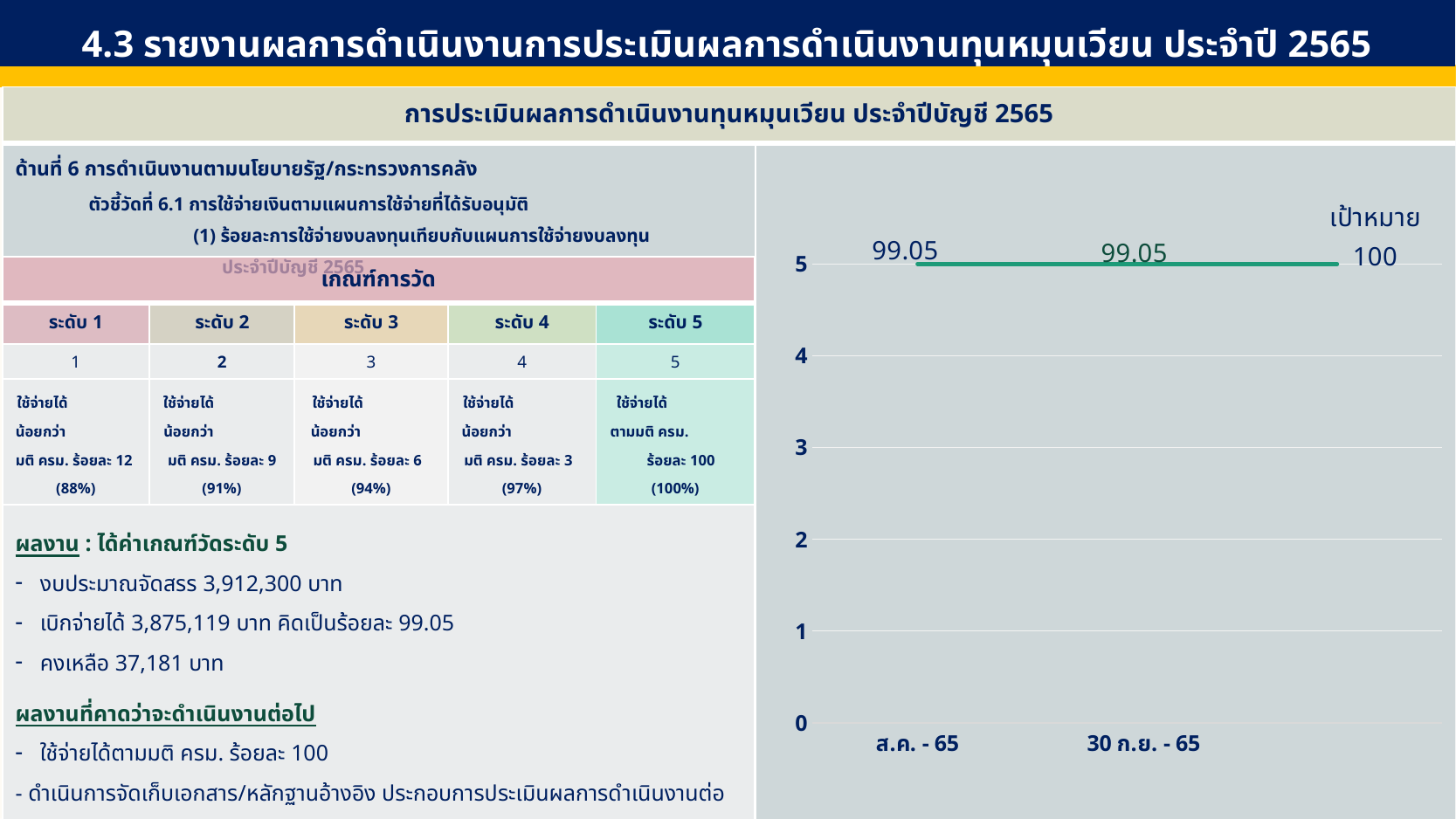
What is the label of the first category on the x axis of the chart? ส.ค. - 65 What target value (เป้าหมาย) is printed at the right end of the line in the chart? 100 Which is larger, the value for ส.ค. - 65 or the value for 30 ก.ย. - 65? they are equal What is the difference between the values for ส.ค. - 65 and 30 ก.ย. - 65? 0 Does the line rise, fall, or stay flat from ส.ค. - 65 to 30 ก.ย. - 65? stays flat What is the label of the second category on the x axis of the chart? 30 ก.ย. - 65 What kind of chart is shown on the right side of the slide? line chart How many categories are shown on the x axis of the chart? 2 What is the data label for ส.ค. - 65 in the chart? 99.05 What is the data label for 30 ก.ย. - 65 in the chart? 99.05 What is the highest tick value shown on the y axis of the chart? 5